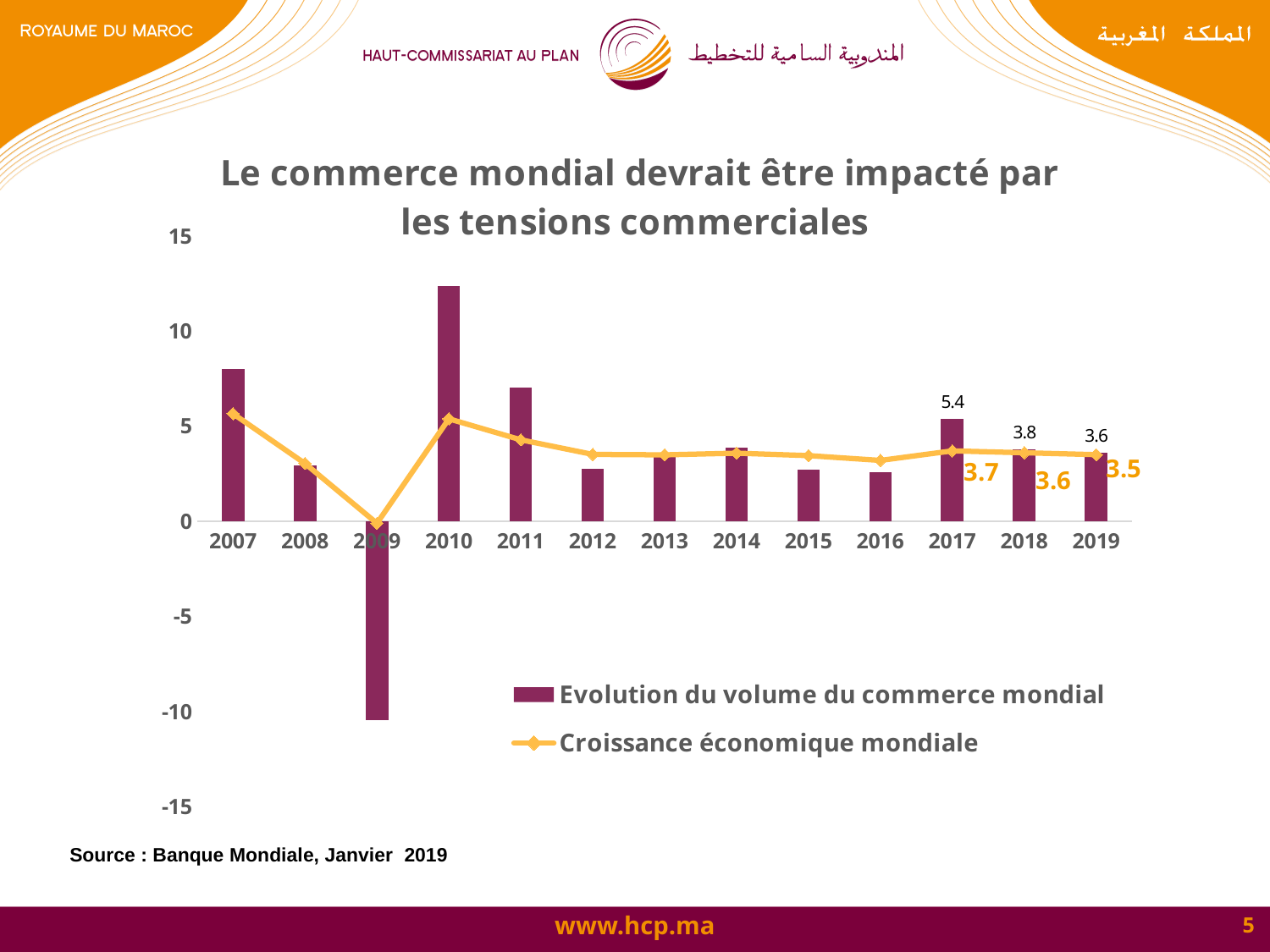
What is the value of Evolution du volume du commerce mondial for 2018? 3.8 What is the value of Croissance économique mondiale for 2017? 3.7 Which is larger in 2018: Evolution du volume du commerce mondial or Croissance économique mondiale? Evolution du volume du commerce mondial How many series does the legend list? 2 How many years are shown on the x axis? 13 What is the difference between Evolution du volume du commerce mondial in 2017 and in 2018? 1.6 What is the value of Croissance économique mondiale for 2019? 3.5 In which year is Evolution du volume du commerce mondial highest? 2010 Is the value of Evolution du volume du commerce mondial for 2010 greater or less than 10? greater What is the value of Evolution du volume du commerce mondial for 2017? 5.4 Does Croissance économique mondiale rise or fall from 2017 to 2019? fall In which year is Evolution du volume du commerce mondial lowest? 2009